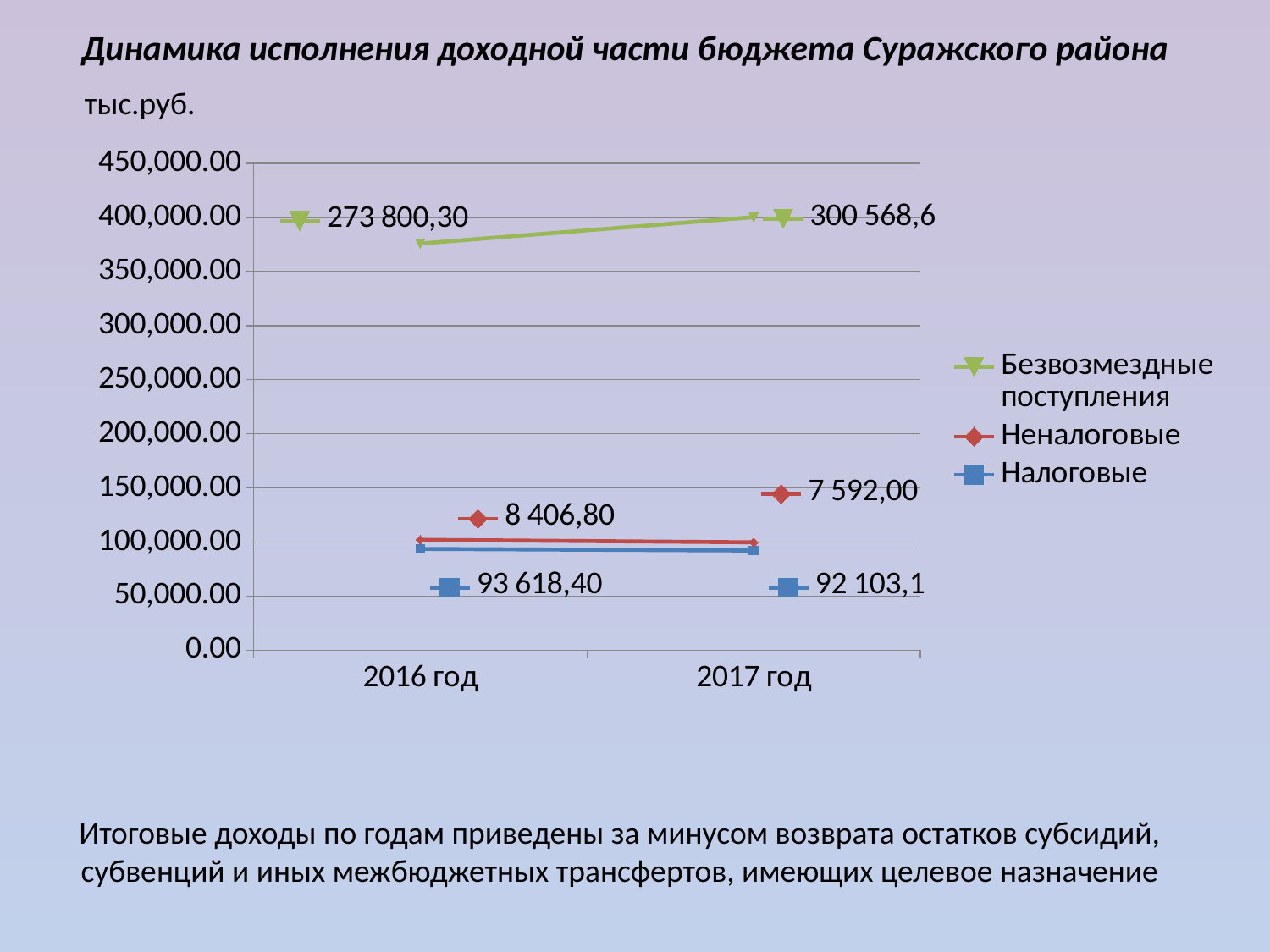
What is the labelled value for Налоговые in 2017 год? 92 103,1 What is the labelled value for Неналоговые in 2017 год? 7 592,00 What is the labelled value for Неналоговые in 2016 год? 8 406,80 What is the labelled value for Налоговые in 2016 год? 93 618,40 How many series does the legend list? 3 What is the labelled value for Безвозмездные поступления in 2017 год? 300 568,6 What unit is stated above the chart? тыс.руб. What kind of chart is shown on the slide? line chart Which year has the larger labelled value for Налоговые, 2016 год or 2017 год? 2016 год How many years are shown on the x axis? 2 What is the labelled value for Безвозмездные поступления in 2016 год? 273 800,30 Do the labelled values for Безвозмездные поступления rise or fall from 2016 год to 2017 год? rise